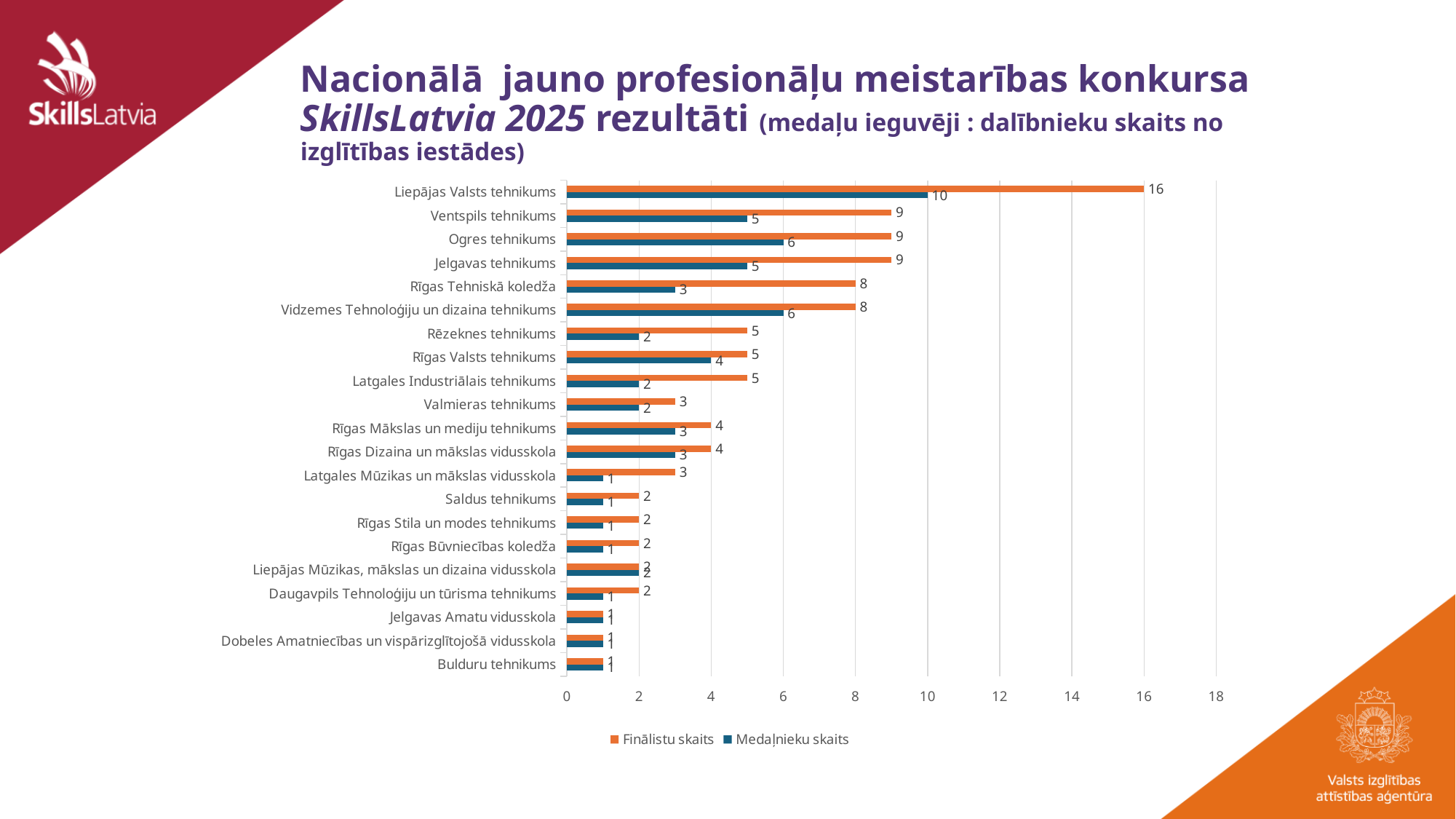
Which institution has the highest Medaļnieku skaits? Liepājas Valsts tehnikums What is the difference between Finālistu skaits and Medaļnieku skaits for Liepājas Valsts tehnikums? 6 What is the Medaļnieku skaits value for Rīgas Tehniskā koledža? 3 What is the Finālistu skaits value for Liepājas Valsts tehnikums? 16 What is the Medaļnieku skaits value for Ogres tehnikums? 6 What type of chart is shown on the slide? bar chart How many educational institutions (categories) are shown in the chart? 21 Which is larger: the Medaļnieku skaits for Ogres tehnikums or for Ventspils tehnikums? Ogres tehnikums What is the difference between the Finālistu skaits for Ventspils tehnikums and for Rēzeknes tehnikums? 4 Which institution has the highest Finālistu skaits? Liepājas Valsts tehnikums How many series does the legend list? 2 Which series is shown in orange in the legend? Finālistu skaits